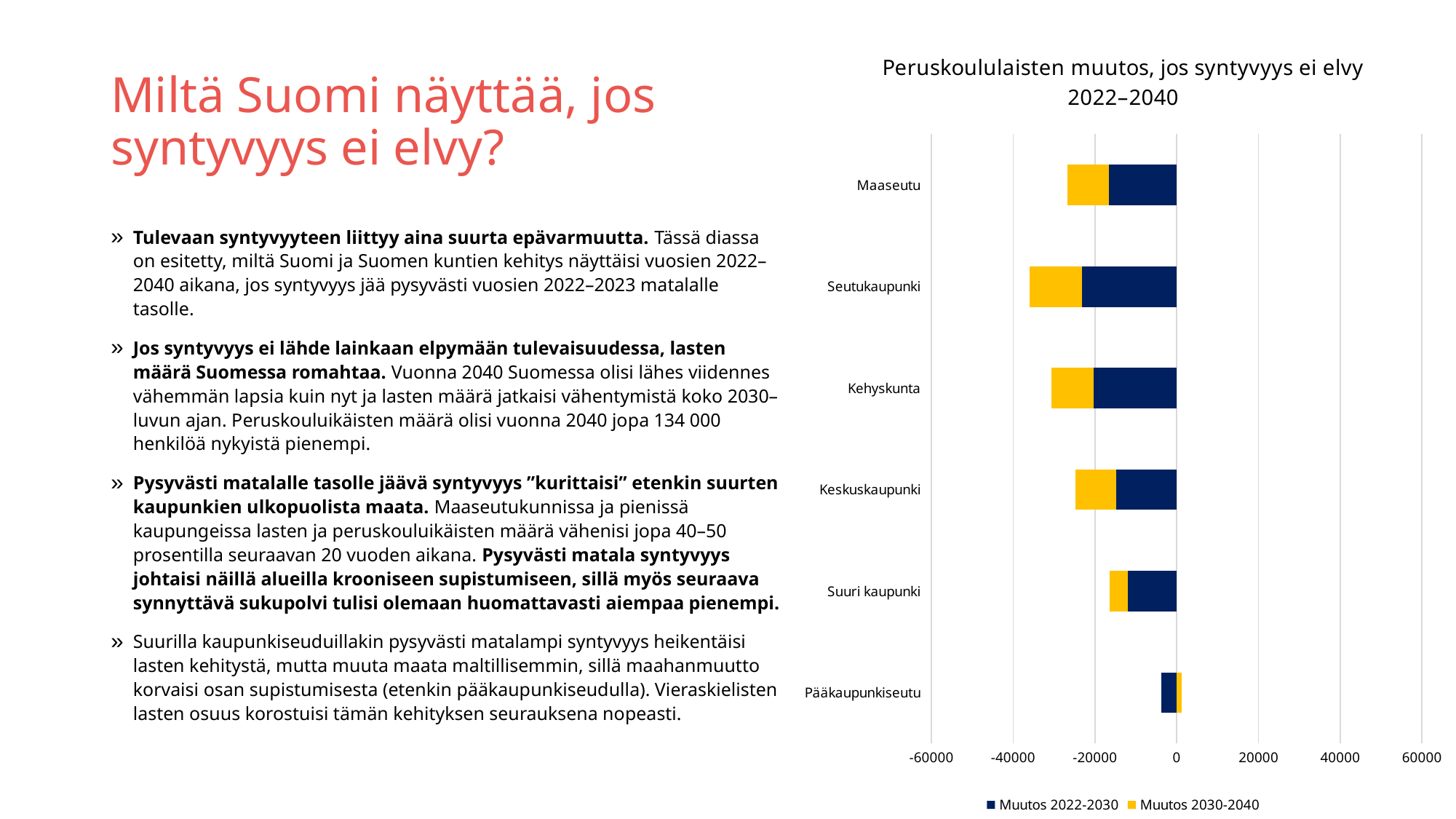
Is the Muutos 2022-2030 value for Maaseutu greater or less than -20000? greater Which category shows the smallest total change in the chart? Pääkaupunkiseutu Which category is the only one with a positive Muutos 2030-2040 value? Pääkaupunkiseutu What kind of chart is shown on the slide? Stacked bar chart Which has a larger total decrease, Seutukaupunki or Suuri kaupunki? Seutukaupunki Which series is shown in yellow in the chart? Muutos 2030-2040 How many series does the chart legend list? 2 Is the total change for Seutukaupunki greater or less than -20000? less Is the Muutos 2022-2030 value for Suuri kaupunki greater or less than -20000? greater What is the title of the chart? Peruskoululaisten muutos, jos syntyvyys ei elvy 2022–2040 Which category shows the largest total decrease in the chart? Seutukaupunki How many categories are shown on the chart's vertical axis? 6